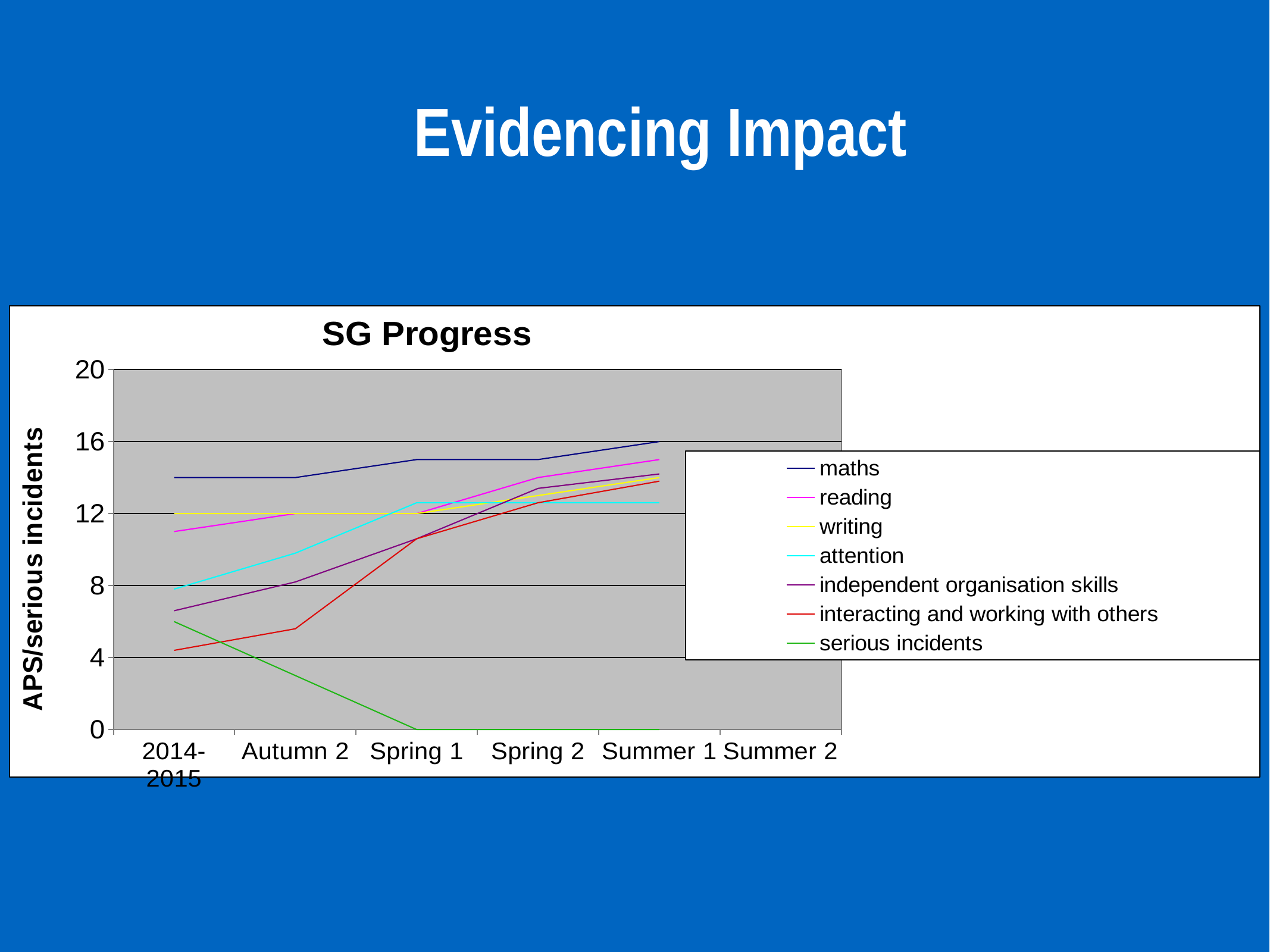
What is the label on the vertical axis? APS/serious incidents What is the value for writing at 2014-2015? 12 What is the value for serious incidents at Summer 1? 0 Do the values for serious incidents rise or fall from 2014-2015 to Spring 1? fall What is the title of the chart? SG Progress Is the value for maths at 2014-2015 greater or less than 12? greater How many categories are shown along the x axis? 6 Which series has the lowest value at 2014-2015? interacting and working with others How many series does the legend list? 7 Which series has the highest value at 2014-2015? maths What kind of chart is shown on the slide? line chart Is the value for independent organisation skills at 2014-2015 greater or less than 8? less